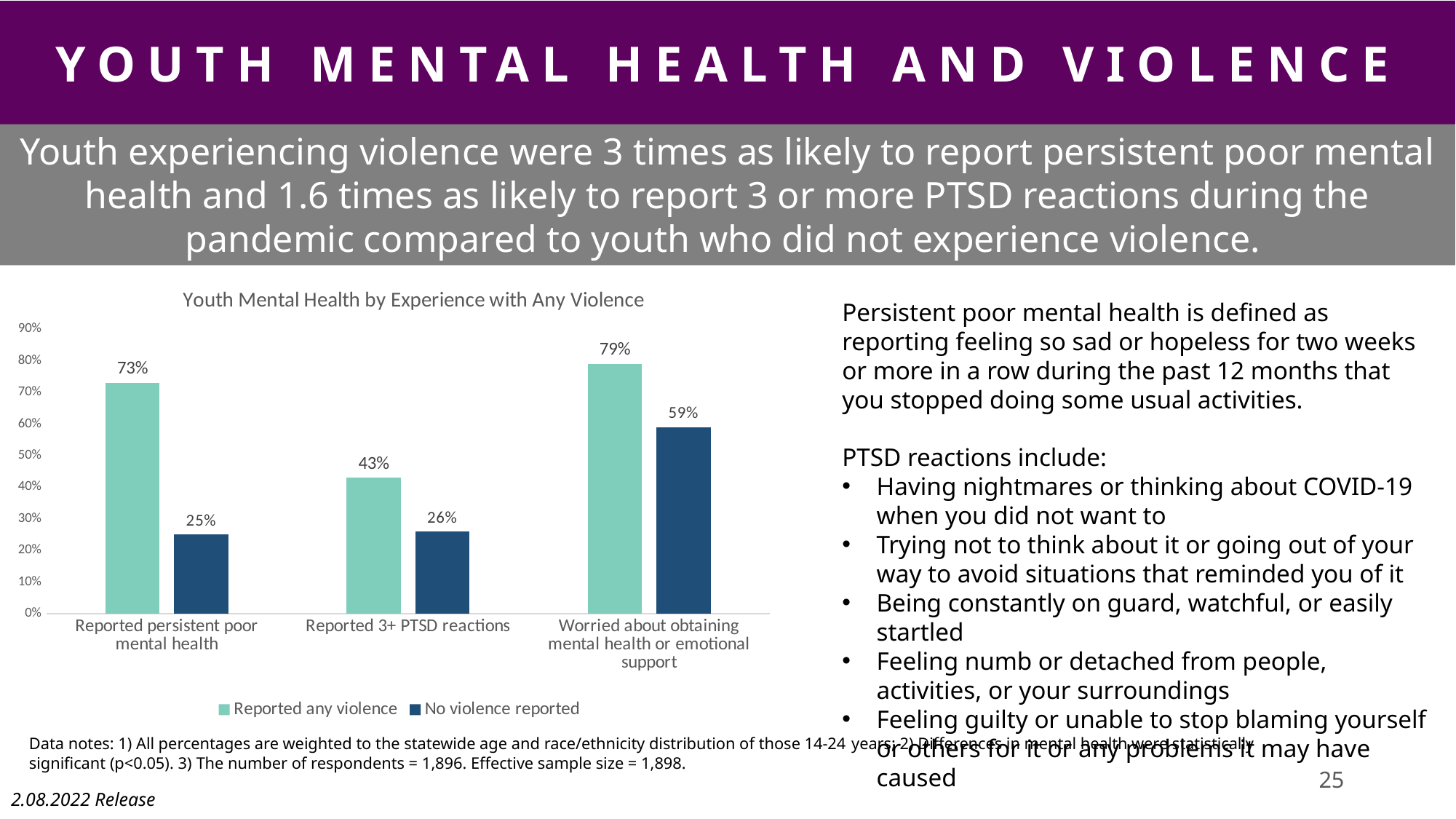
How many series does the chart legend list? 2 What percentage of youth with no violence reported reported 3+ PTSD reactions? 26% How many categories are shown on the x axis of the chart? 3 What percentage of youth who reported any violence reported persistent poor mental health? 73% What is the title of the chart? Youth Mental Health by Experience with Any Violence What percentage of youth who reported any violence were worried about obtaining mental health or emotional support? 79% What is the difference between the 'Reported any violence' and 'No violence reported' values for 'Reported persistent poor mental health'? 48 percentage points Which category has the lowest value for the 'No violence reported' series? Reported persistent poor mental health For 'Reported 3+ PTSD reactions', which series has the larger value: 'Reported any violence' or 'No violence reported'? Reported any violence Is the 'No violence reported' value for 'Worried about obtaining mental health or emotional support' greater or less than 50%? greater What type of chart is shown on the slide? Bar chart Which category has the highest value for the 'Reported any violence' series? Worried about obtaining mental health or emotional support